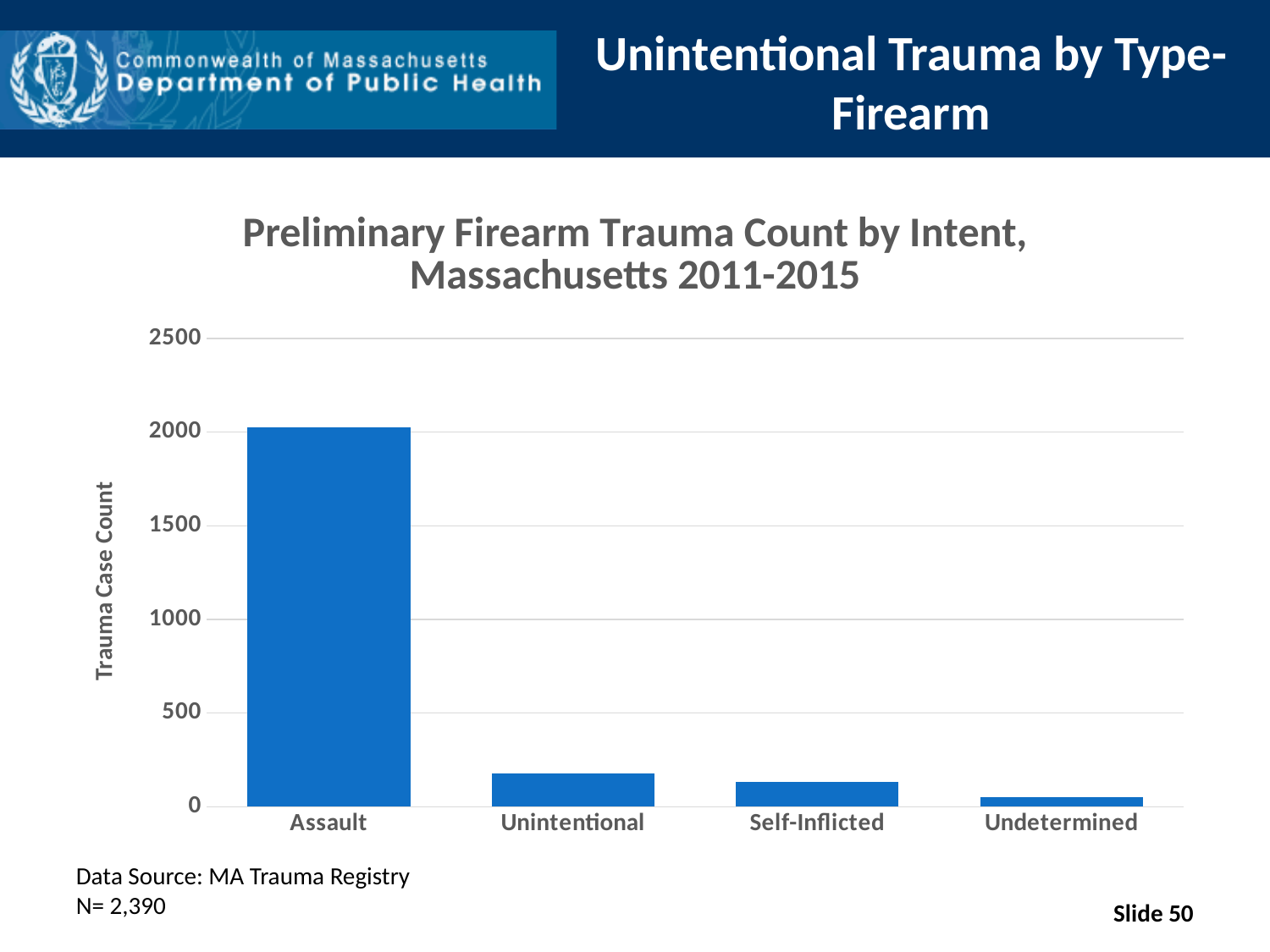
Which has a larger trauma case count, Unintentional or Self-Inflicted? Unintentional Is the trauma case count for Self-Inflicted greater or less than 500? less What kind of chart is shown on the slide? bar chart What is the title of the chart? Preliminary Firearm Trauma Count by Intent, Massachusetts 2011-2015 Do the trauma case counts rise or fall moving from left to right across the categories? fall How many intent categories are shown on the x axis? 4 Which has a larger trauma case count, Self-Inflicted or Undetermined? Self-Inflicted What is the label of the vertical axis? Trauma Case Count Which intent category has the highest trauma case count? Assault Is the trauma case count for Unintentional greater or less than 500? less Which intent category has the lowest trauma case count? Undetermined